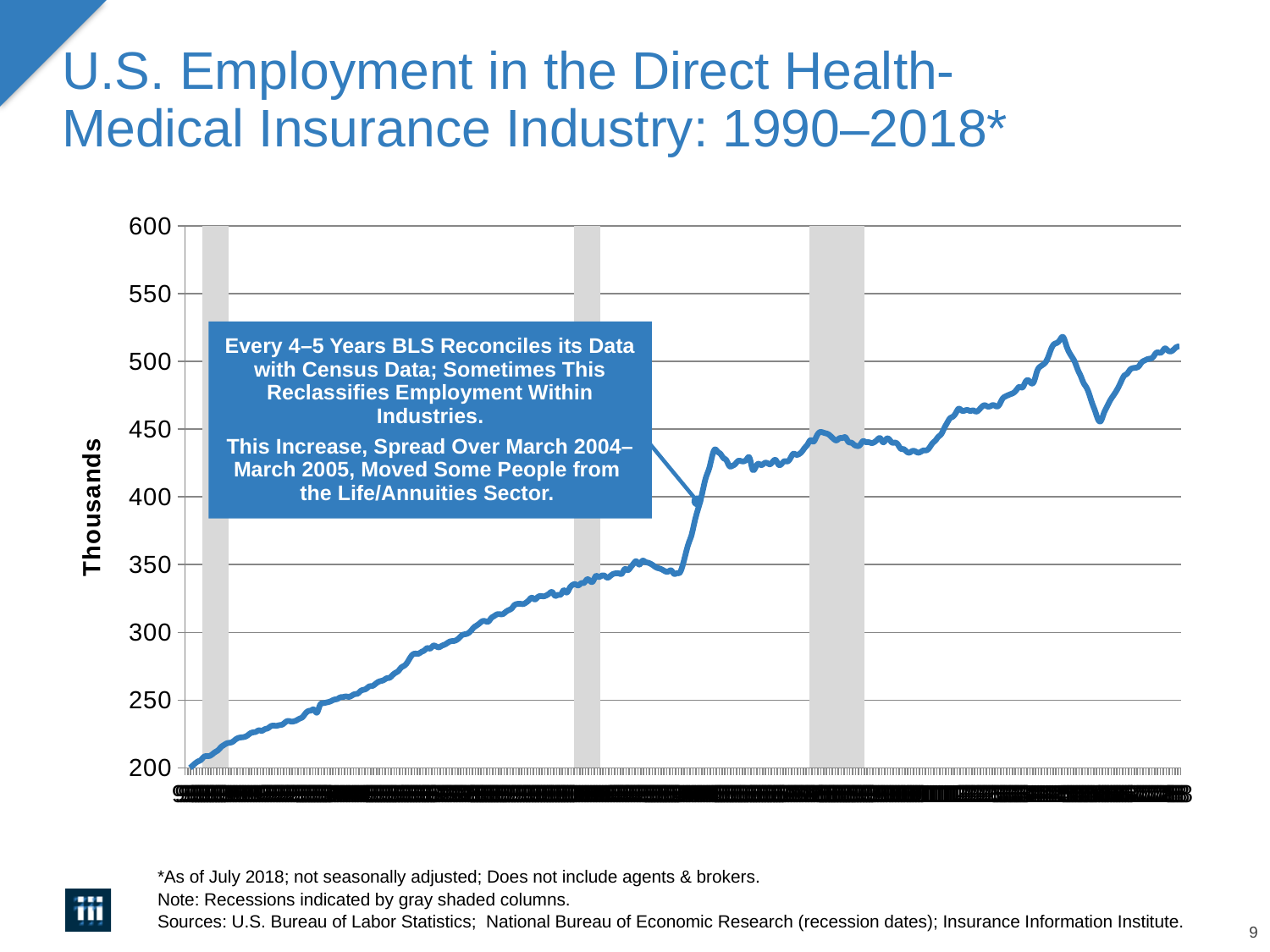
Is the value at the start of the series greater or less than 250? less Is the lowest value on the line greater or less than 300? less Is the value at the end of the series greater or less than the value at the start of the series? greater What is the label on the vertical axis of the chart? Thousands Is the value at the end of the series greater or less than 500? greater What is the highest tick value shown on the vertical axis? 600 What kind of chart is shown on the slide? line chart Overall, do the values rise or fall from the start of the series to the end? rise What do the gray shaded columns on the chart indicate? Recessions How many gray shaded recession columns appear on the chart? 3